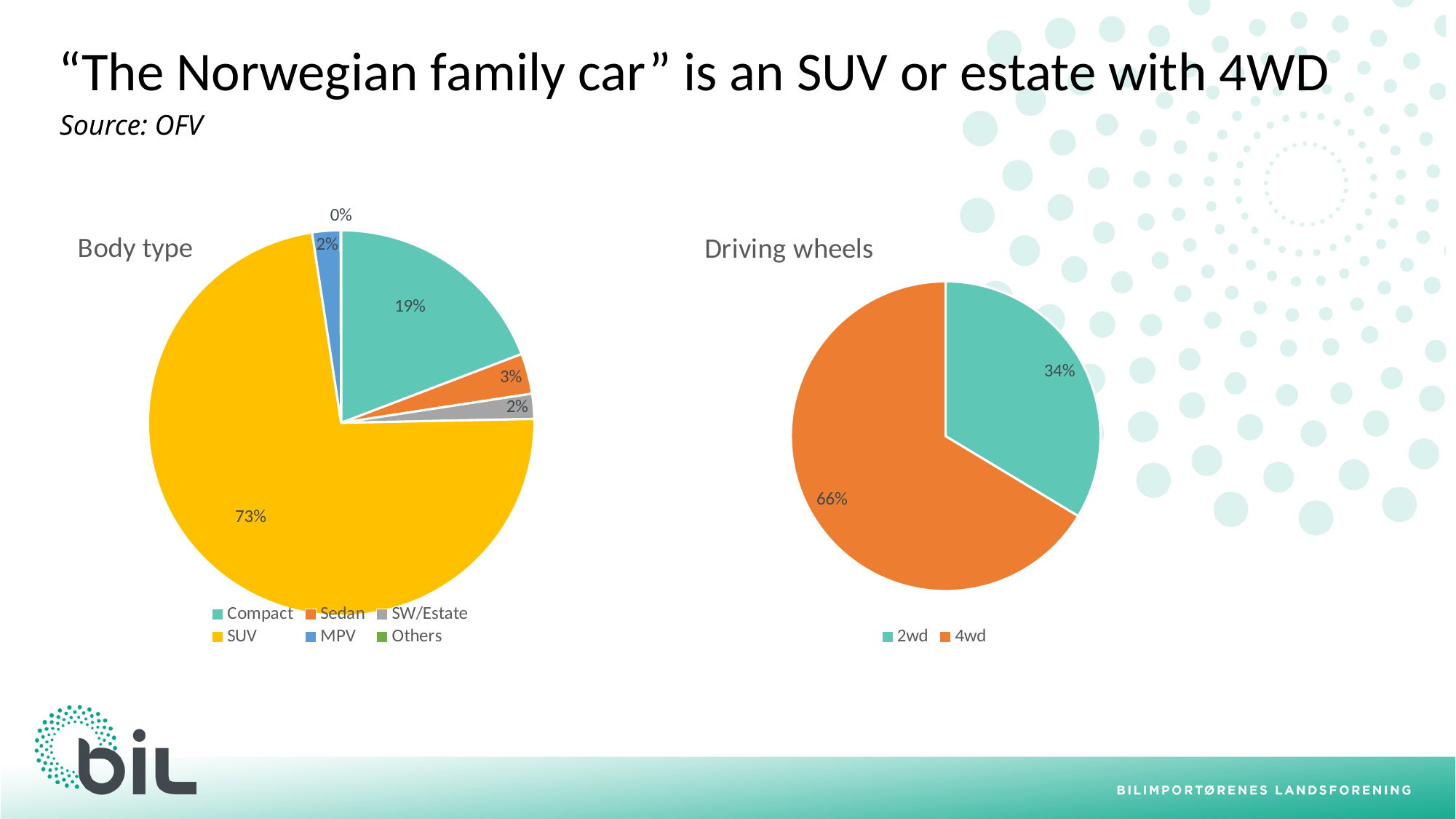
In the Body type chart, what is the value for Compact? 19% In the Body type chart, what share of the pie is SUV? 73% In the Body type chart, what is the difference between the SUV and Compact shares? 54% In the Driving wheels chart, which is larger, 2wd or 4wd? 4wd In the Body type chart, which body type has the smallest share? Others In the Driving wheels chart, what is the value for 2wd? 34% In the Body type chart, what is the value for Sedan? 3% In the Body type chart, how many categories does the legend list? 6 In the Driving wheels chart, what share of the pie is 4wd? 66% What kind of chart is the Driving wheels chart? Pie chart In the Body type chart, which body type has the largest share? SUV In the Driving wheels chart, what is the difference between the 4wd and 2wd shares? 32%